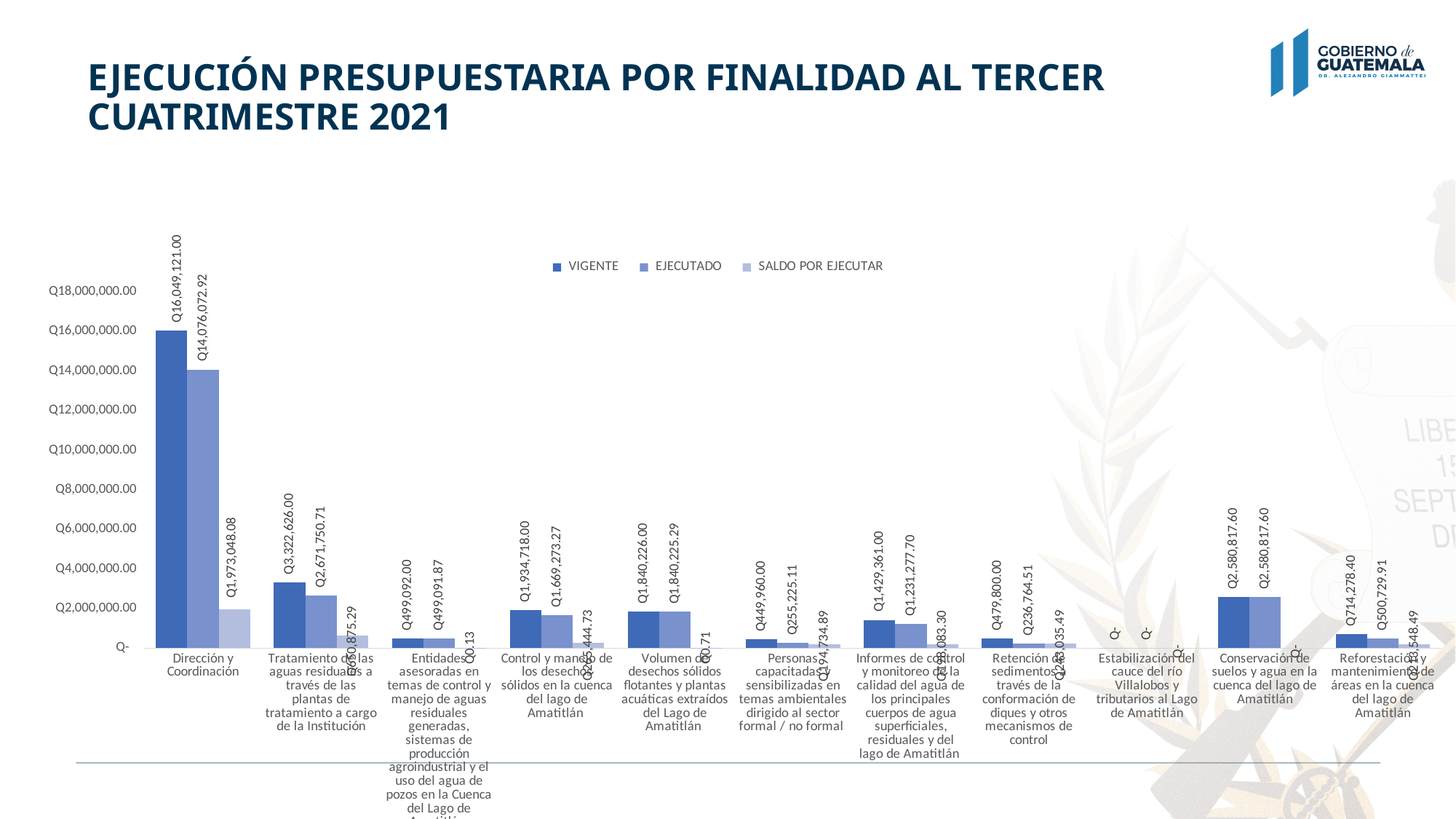
How many categories are shown on the x axis? 11 What is the VIGENTE value for Volumen de desechos sólidos flotantes y plantas acuáticas extraídos del Lago de Amatitlán? Q1,840,226.00 Is the EJECUTADO value for Dirección y Coordinación greater or less than Q12,000,000.00? greater What kind of chart is shown on the slide? Bar chart What is the EJECUTADO value for Dirección y Coordinación? Q14,076,072.92 Which category has the highest VIGENTE value? Dirección y Coordinación What is the difference between the VIGENTE and EJECUTADO values for Dirección y Coordinación? Q1,973,048.08 What is the SALDO POR EJECUTAR value for Dirección y Coordinación? Q1,973,048.08 What is the VIGENTE value for Dirección y Coordinación? Q16,049,121.00 What is the EJECUTADO value for Conservación de suelos y agua en la cuenca del lago de Amatitlán? Q2,580,817.60 Which is larger, the VIGENTE value for Tratamiento de las aguas residuales or the VIGENTE value for Conservación de suelos y agua? Tratamiento de las aguas residuales How many series does the legend list? 3